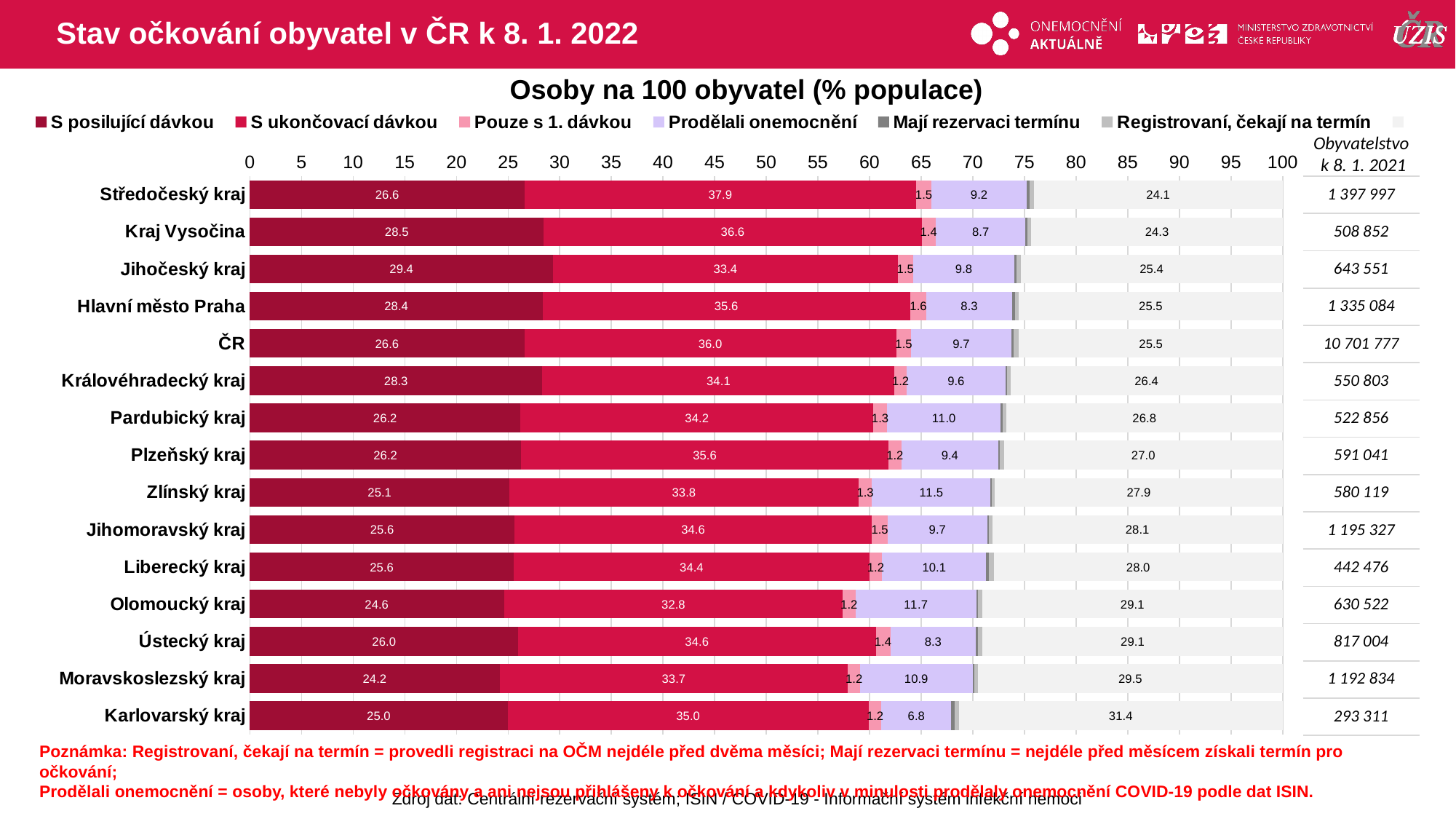
Which category has the lowest value for 'S posilující dávkou'? Moravskoslezský kraj Which category has the highest value for 'S posilující dávkou'? Jihočeský kraj What is the value of 'S ukončovací dávkou' for Středočeský kraj? 37.9 Which category has the lowest value for 'Prodělali onemocnění'? Karlovarský kraj What is the value of 'Pouze s 1. dávkou' for Hlavní město Praha? 1.6 What is the value of 'S posilující dávkou' for Jihočeský kraj? 29.4 What is the title of the chart? Osoby na 100 obyvatel (% populace) How many categories (rows) are shown in the chart? 15 What is the difference between the 'S ukončovací dávkou' values for Středočeský kraj and Olomoucký kraj? 5.1 Which has a larger 'S posilující dávkou' value, Jihočeský kraj or Karlovarský kraj? Jihočeský kraj What is the value of 'Prodělali onemocnění' for Pardubický kraj? 11.0 What kind of chart is shown on the slide? Stacked bar chart